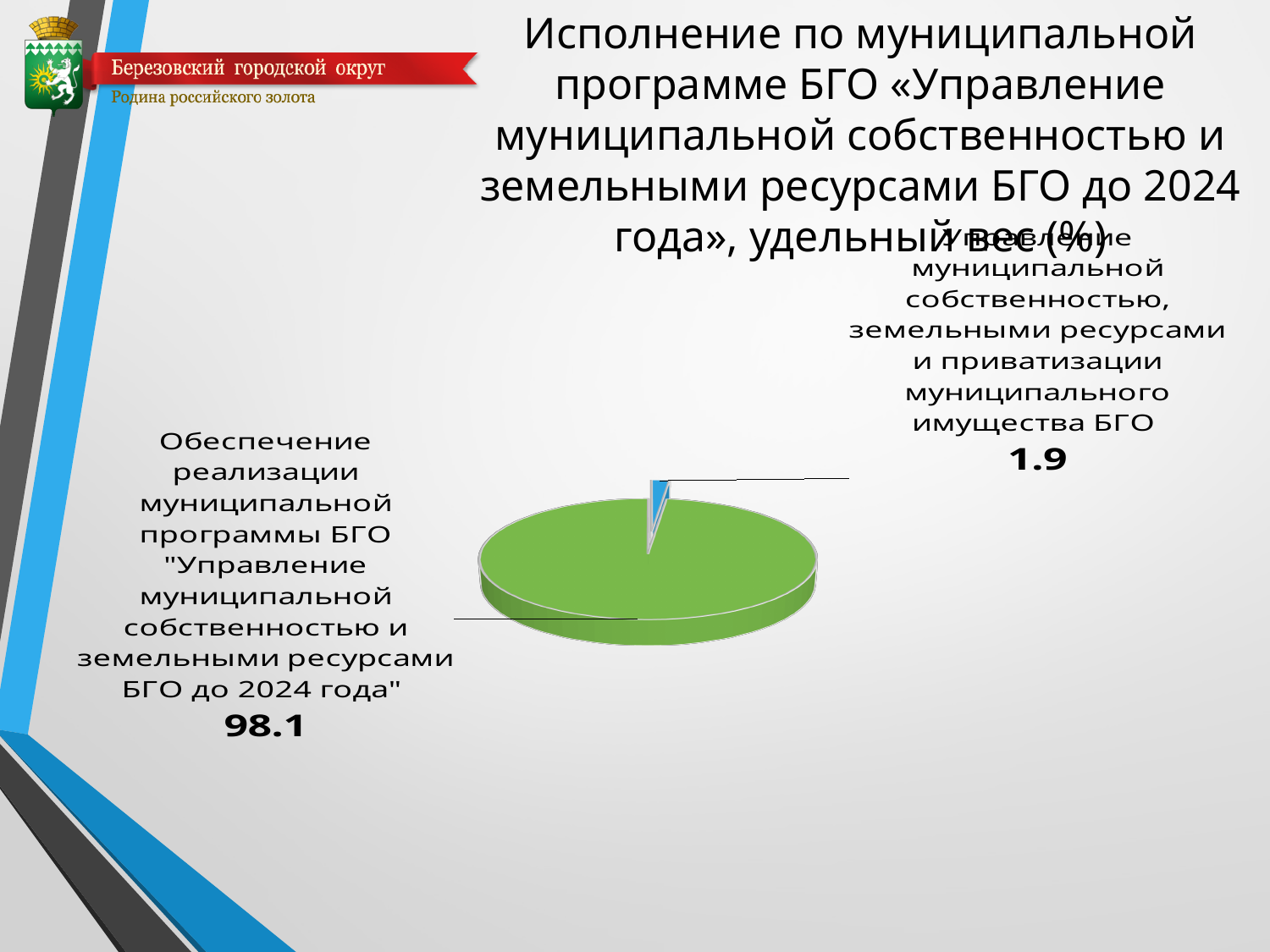
What is the value shown for the slice labelled "Управление муниципальной собственностью, земельными ресурсами и приватизации муниципального имущества БГО"? 1.9 How many slices does the pie chart have? 2 Which slice of the pie chart is the smallest? Управление муниципальной собственностью, земельными ресурсами и приватизации муниципального имущества БГО What is the difference between the two slice values, 98.1 and 1.9? 96.2 What is the value shown for the slice labelled "Обеспечение реализации муниципальной программы БГО "Управление муниципальной собственностью и земельными ресурсами БГО до 2024 года""? 98.1 Which slice of the pie chart is the largest? Обеспечение реализации муниципальной программы БГО "Управление муниципальной собственностью и земельными ресурсами БГО до 2024 года" Which is larger: the slice for "Обеспечение реализации муниципальной программы БГО..." or the slice for "Управление муниципальной собственностью, земельными ресурсами и приватизации муниципального имущества БГО"? Обеспечение реализации муниципальной программы БГО... What colour is the smallest slice of the pie chart? blue What is the total of the two slice values shown on the pie chart? 100 What kind of chart is shown on the slide? pie chart What colour is the largest slice of the pie chart? green